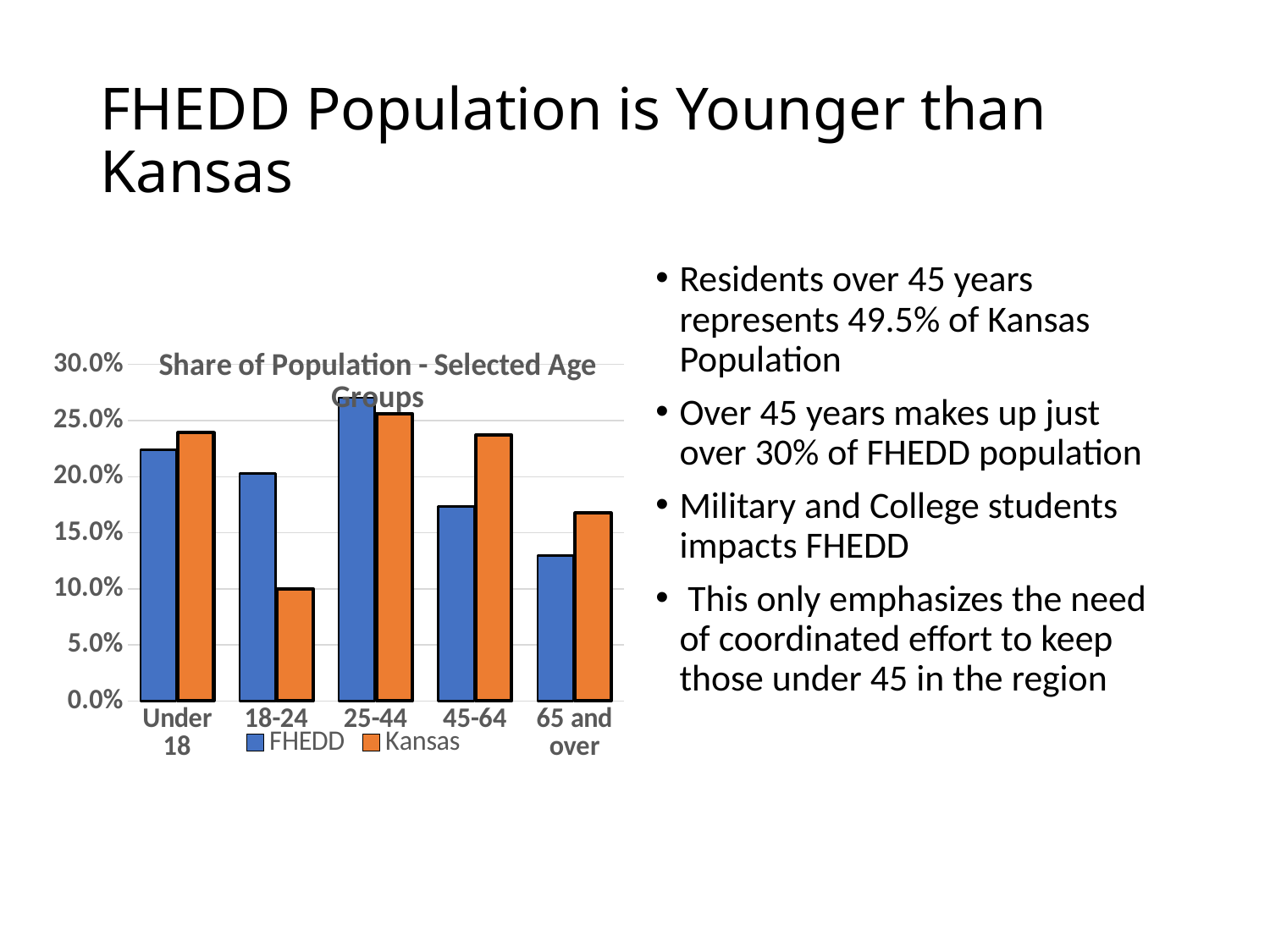
How many age group categories are shown on the x axis? 5 Is the FHEDD value for 25-44 greater or less than 25.0%? greater Which age group has the lowest FHEDD share? 65 and over What kind of chart is shown on the slide? Bar chart For the 18-24 age group, which is larger, FHEDD or Kansas? FHEDD How many series does the chart's legend list? 2 Which colour represents the Kansas series in the chart? Orange Which age group has the highest FHEDD share? 25-44 What is the title of the chart? Share of Population - Selected Age Groups For the 45-64 age group, which is larger, FHEDD or Kansas? Kansas Is the Kansas value for 18-24 greater or less than 15.0%? less Which age group has the lowest Kansas share? 18-24